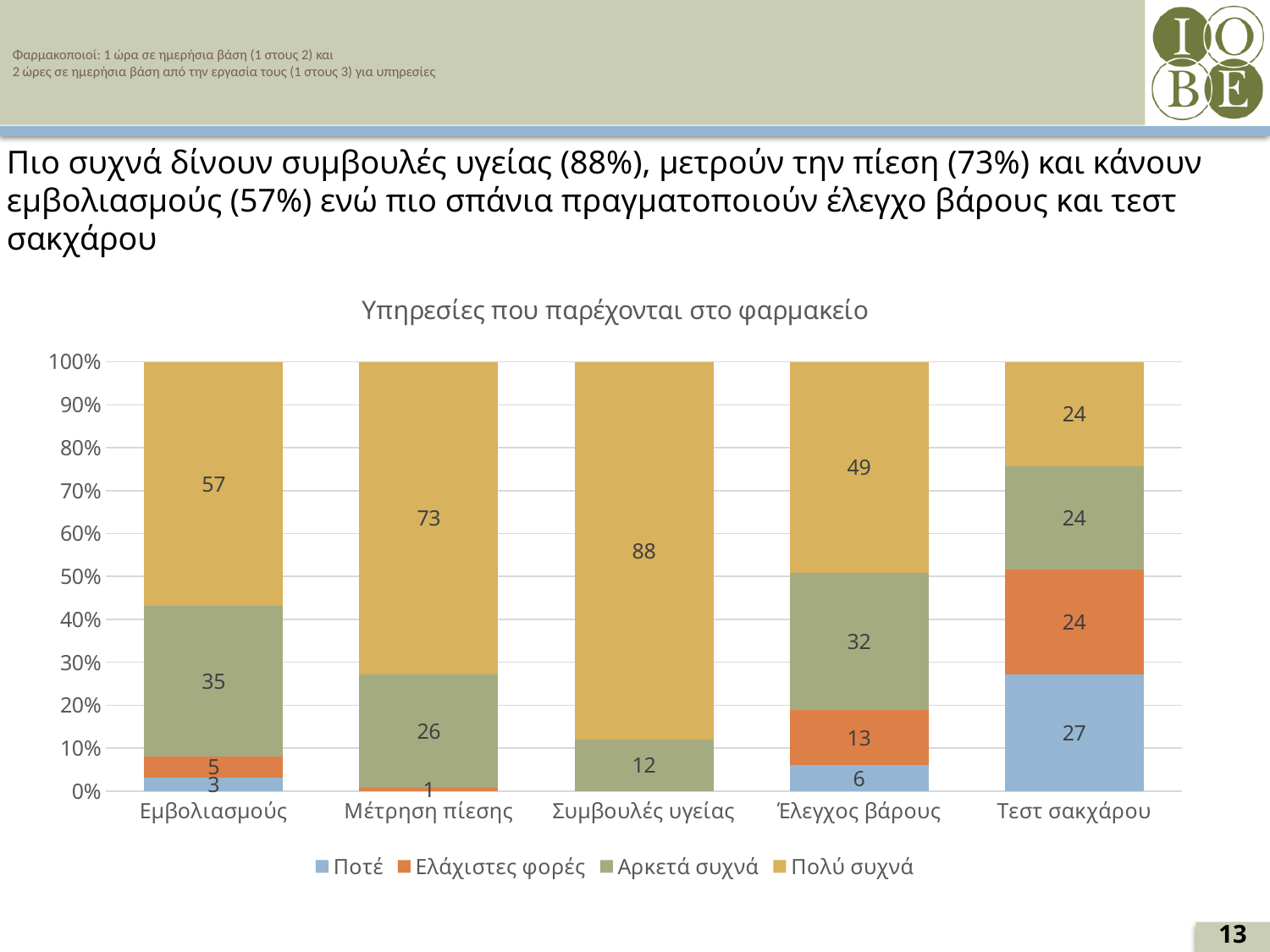
What is the value of the 'Πολύ συχνά' segment for 'Συμβουλές υγείας'? 88 What is the difference between the 'Πολύ συχνά' values for 'Μέτρηση πίεσης' and 'Εμβολιασμούς'? 16 Which category has the lowest 'Πολύ συχνά' value? Τεστ σακχάρου What kind of chart is shown? Stacked bar chart Which is larger: the 'Αρκετά συχνά' value for 'Εμβολιασμούς' or for 'Μέτρηση πίεσης'? Εμβολιασμούς How many categories are shown on the x axis? 5 What is the value of the 'Αρκετά συχνά' segment for 'Έλεγχος βάρους'? 32 What is the value of the 'Ελάχιστες φορές' segment for 'Εμβολιασμούς'? 5 What is the value of the 'Ποτέ' segment for 'Τεστ σακχάρου'? 27 How many series does the legend list? 4 What is the title of the chart? Υπηρεσίες που παρέχονται στο φαρμακείο Which category has the highest 'Πολύ συχνά' value? Συμβουλές υγείας